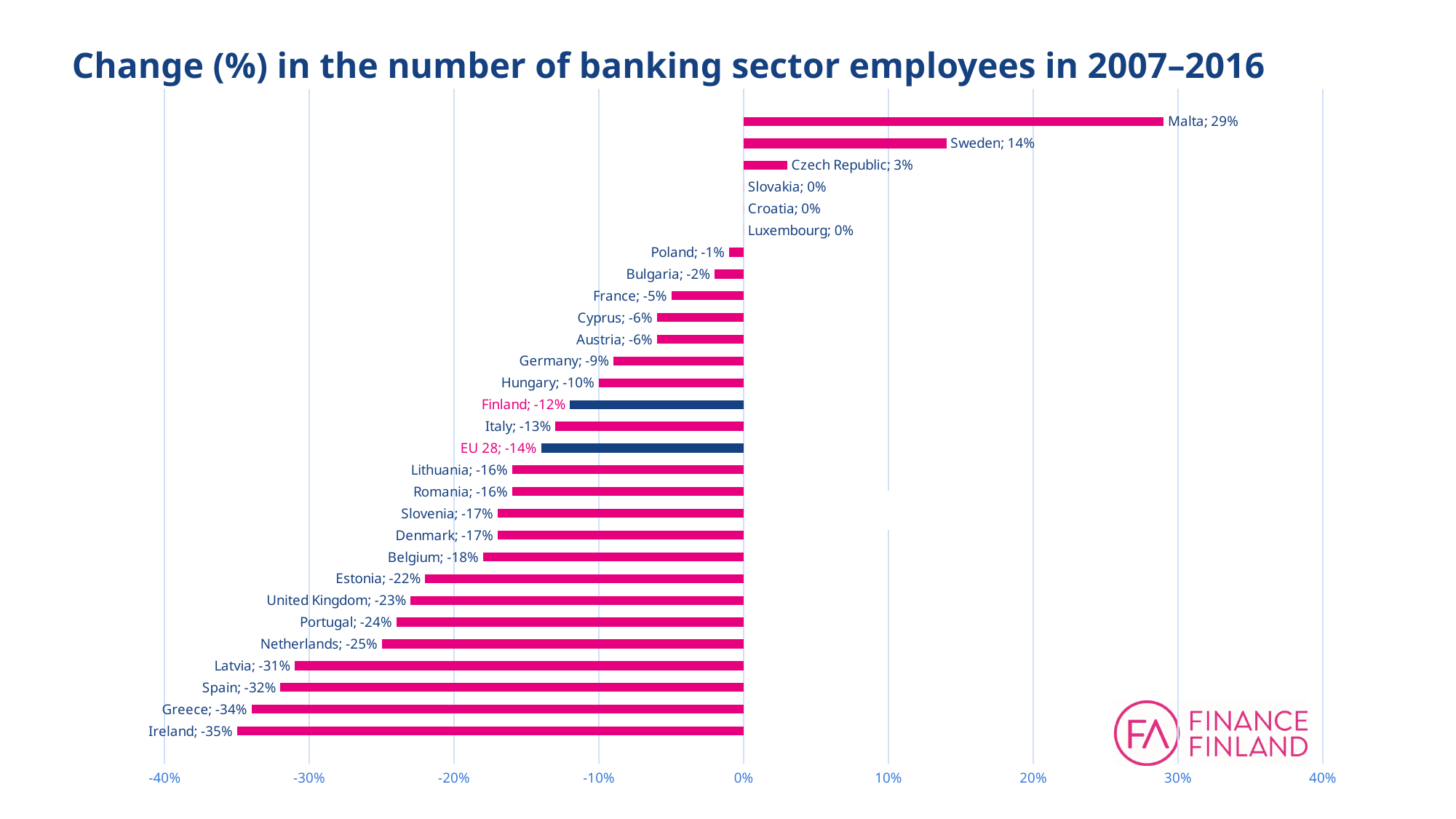
What is the value for EU 28? -14% What is the difference between the values for Sweden and Malta? 15 percentage points What is the value for Malta? 29% Which two bars are coloured dark blue instead of pink? Finland and EU 28 What kind of chart is shown on the slide? Bar chart How many categories are plotted in the chart? 29 Which country has the highest value? Malta Which has a larger value, Finland or Italy? Finland What is the value for Finland? -12% What is the difference between the values for Finland and EU 28? 2 percentage points Which country has the lowest value? Ireland What is the title of the chart? Change (%) in the number of banking sector employees in 2007–2016